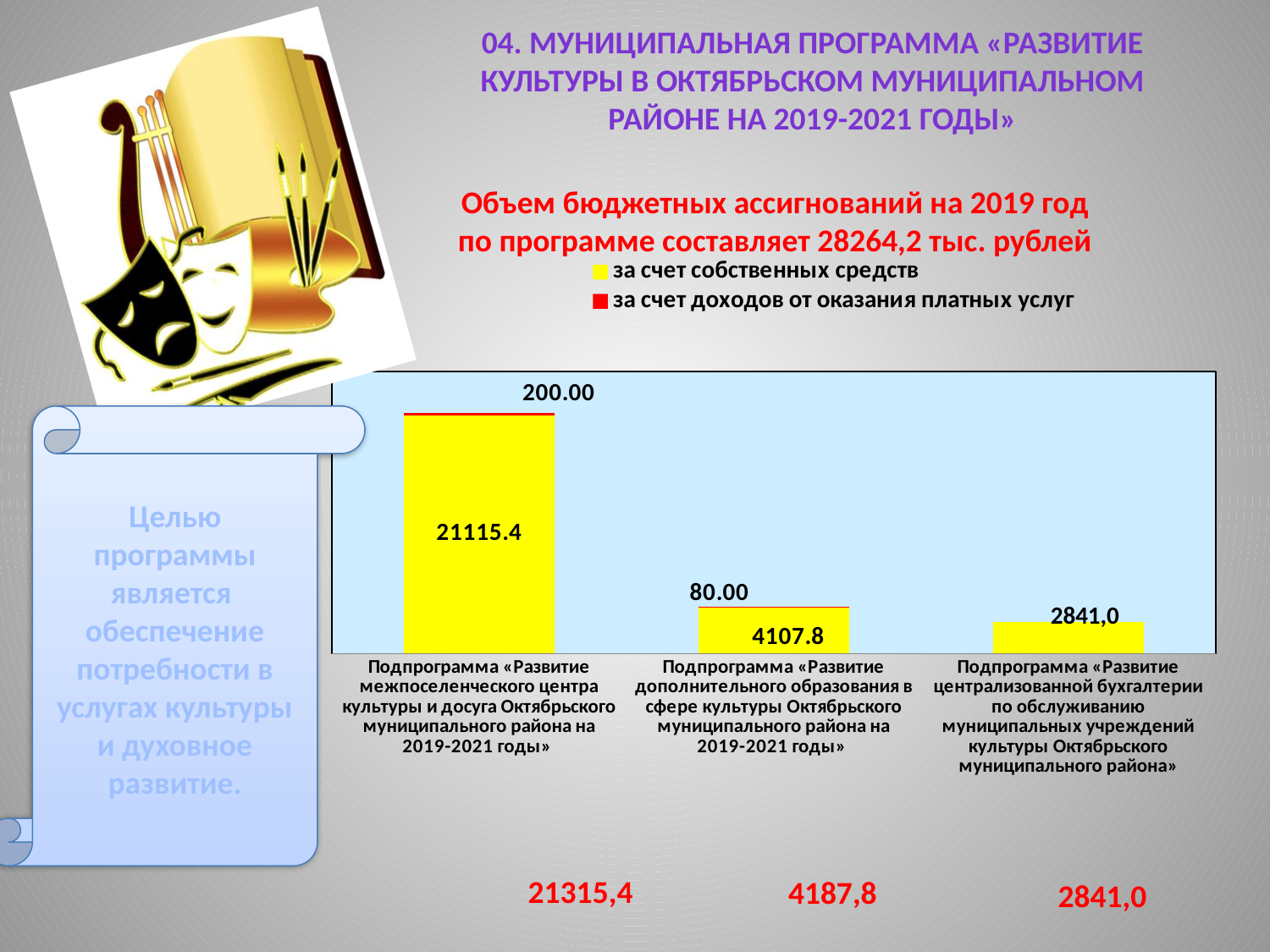
What is the value of income from paid services for the subprogram «Развитие дополнительного образования в сфере культуры»? 80.00 What kind of chart is shown on the slide? Bar chart Which subprogram has the lowest value of own funds? Подпрограмма «Развитие централизованной бухгалтерии по обслуживанию муниципальных учреждений культуры Октябрьского муниципального района» How many series does the legend list? 2 What is the value of own funds for the subprogram «Развитие дополнительного образования в сфере культуры Октябрьского муниципального района на 2019-2021 годы»? 4107.8 What is the difference between the paid-services values of the subprogram «Развитие межпоселенческого центра культуры и досуга» (200.00) and the subprogram «Развитие дополнительного образования в сфере культуры» (80.00)? 120.00 Which subprogram has the highest value of own funds? Подпрограмма «Развитие межпоселенческого центра культуры и досуга Октябрьского муниципального района на 2019-2021 годы» How many subprograms (categories) are shown in the chart? 3 What is the value of own funds (за счет собственных средств) for the subprogram «Развитие межпоселенческого центра культуры и досуга Октябрьского муниципального района на 2019-2021 годы»? 21115.4 Which has the larger own-funds value: the subprogram «Развитие дополнительного образования в сфере культуры» or the subprogram «Развитие централизованной бухгалтерии»? Подпрограмма «Развитие дополнительного образования в сфере культуры» What is the value of income from paid services (за счет доходов от оказания платных услуг) for the subprogram «Развитие межпоселенческого центра культуры и досуга»? 200.00 What is the value shown for the subprogram «Развитие централизованной бухгалтерии по обслуживанию муниципальных учреждений культуры Октябрьского муниципального района»? 2841,0